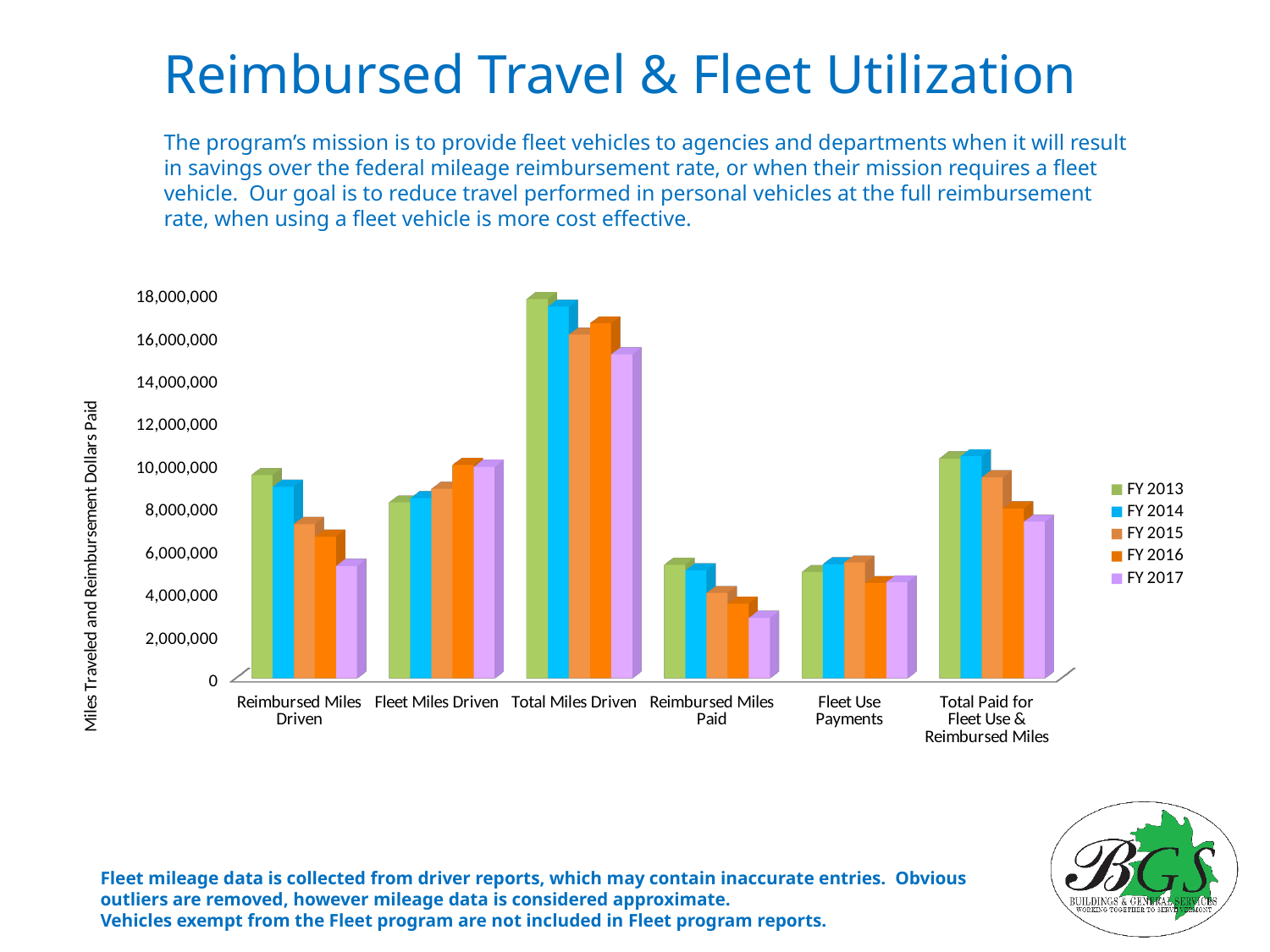
Do the Reimbursed Miles Driven values rise or fall from FY 2013 to FY 2017? fall What is the title of the vertical axis? Miles Traveled and Reimbursement Dollars Paid For Reimbursed Miles Driven, which is larger: the FY 2013 value or the FY 2017 value? FY 2013 Which category has the lowest FY 2017 value? Reimbursed Miles Paid How many series does the legend list? 5 Is the FY 2016 value for Total Paid for Fleet Use & Reimbursed Miles greater or less than 10,000,000? less Is the FY 2013 value for Total Miles Driven greater or less than 16,000,000? greater Is the FY 2017 value for Reimbursed Miles Driven greater or less than 6,000,000? less What kind of chart is shown on the slide? Bar chart Which category has the highest FY 2013 value? Total Miles Driven For FY 2016, which is larger: Fleet Miles Driven or Reimbursed Miles Driven? Fleet Miles Driven How many categories are shown along the x axis? 6